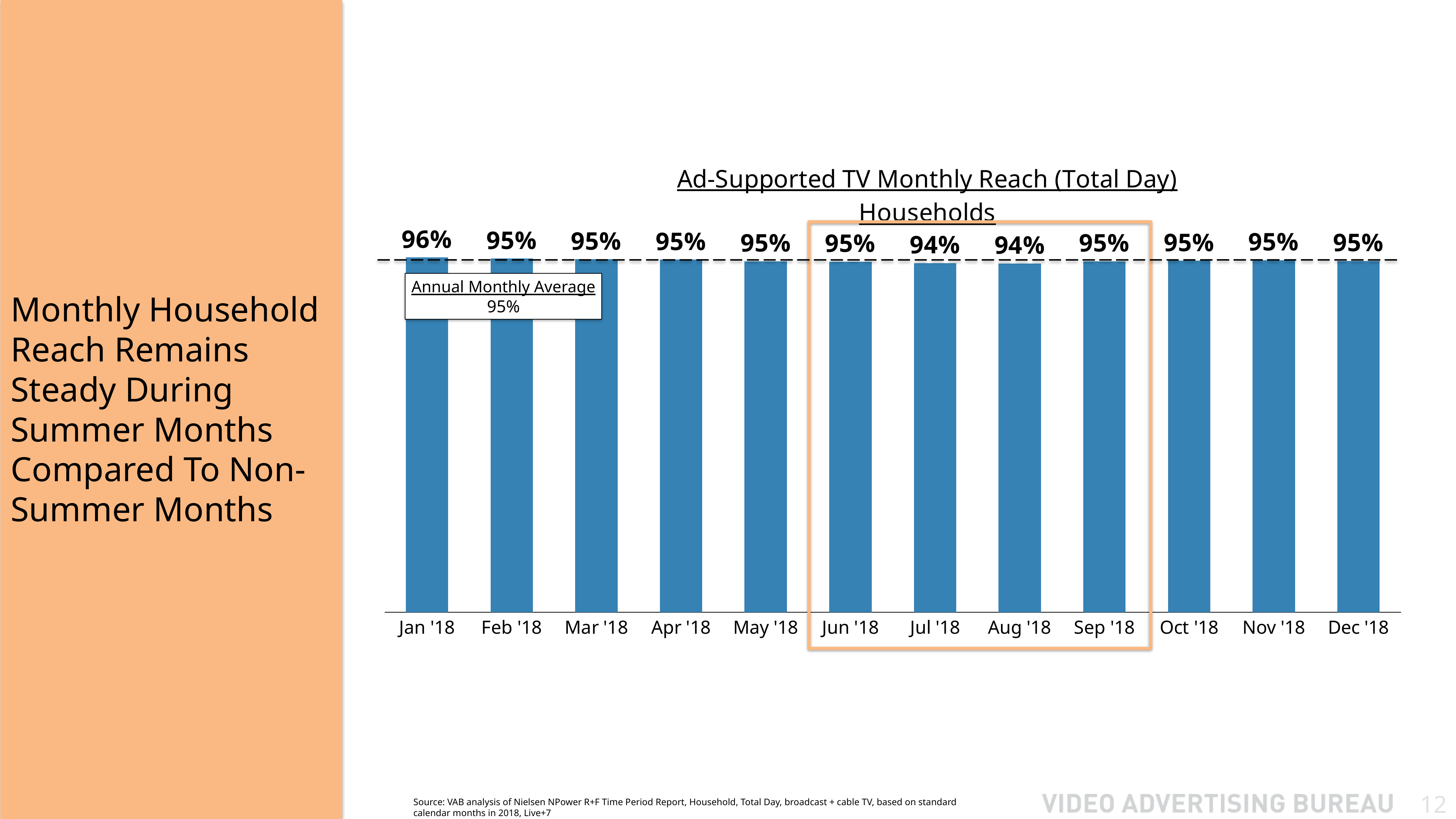
Which months are enclosed by the orange highlight box? Jun '18 through Sep '18 What is the Annual Monthly Average shown on the chart? 95% How many months are shown on the chart? 12 What is the lowest value shown on the chart? 94% Which is larger, the value for Jan '18 or the value for Aug '18? Jan '18 What is the value for Jan '18? 96% Which month has the highest value? Jan '18 What kind of chart is this? Bar chart What is the value for Aug '18? 94% What is the value for Dec '18? 95% What is the value for Jul '18? 94% What is the difference between the values for Jan '18 and Jul '18? 2 percentage points